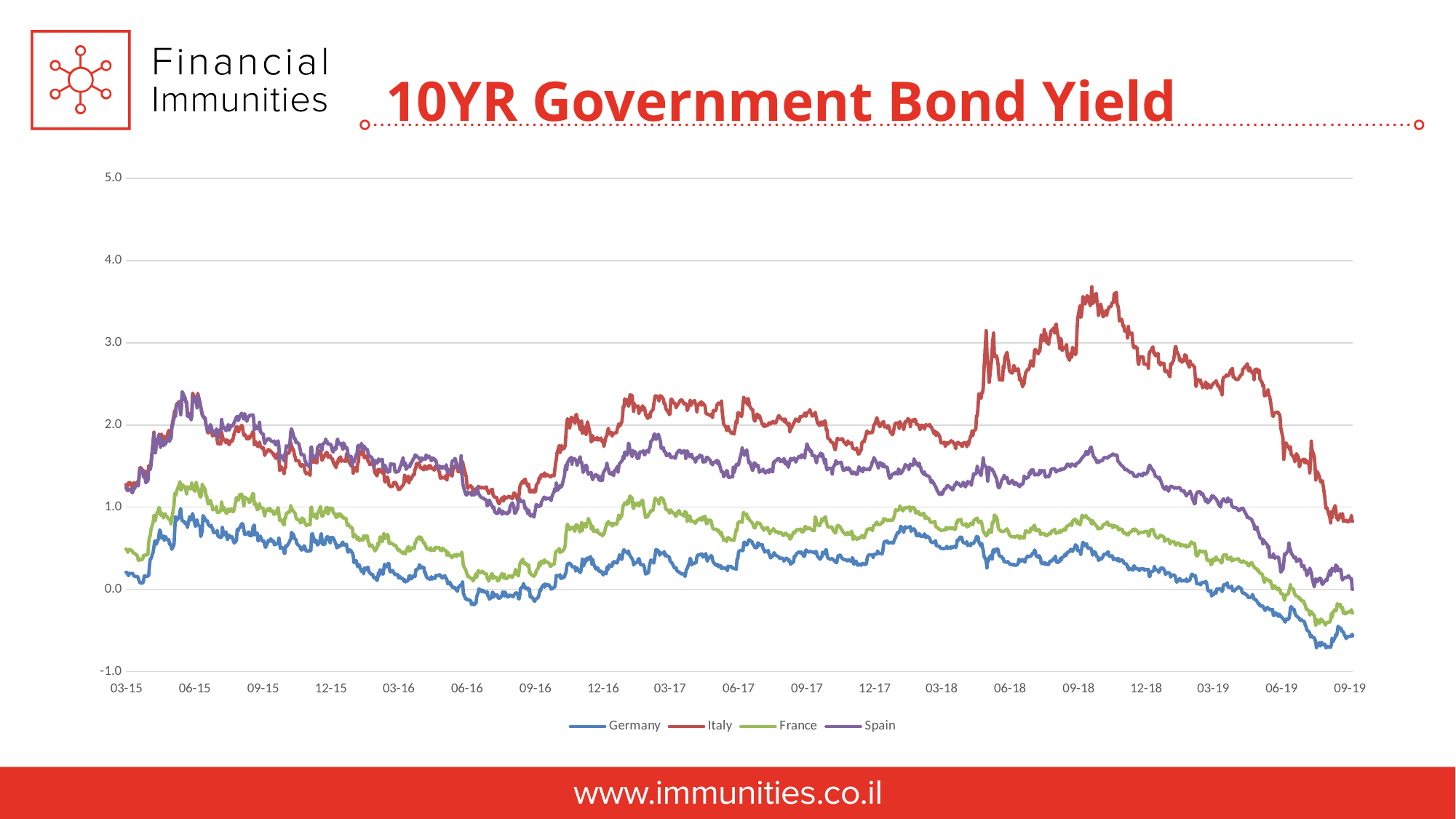
Is the value for Spain around 06-15 greater or less than 2.0? greater Is the value for Germany at 09-19 greater or less than 0.0? less Which colour is used for the Italy line? red How many series does the legend list? 4 Is the value for France at 09-19 greater or less than 0.0? less Which series has the lowest value at 09-19? Germany Which series has the highest value at 09-19? Italy What is the title of the chart? 10YR Government Bond Yield What kind of chart is shown on the slide? line chart Does the Germany line rise or fall between 03-18 and 09-19? fall